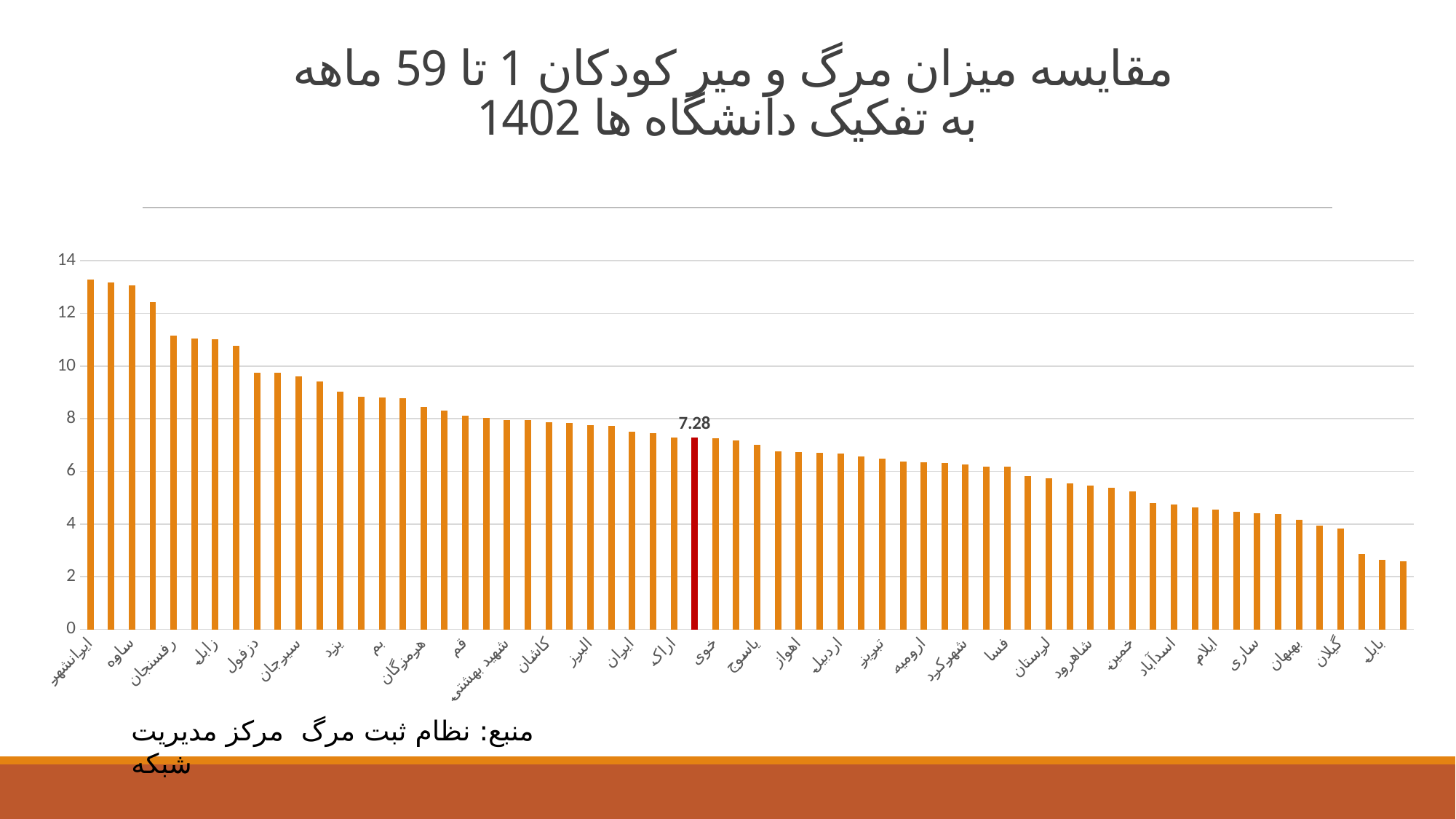
Is the value for خوی greater or less than 8? less Is the value for یزد greater or less than 8? greater Is the value for دزفول greater or less than 10? less Do the values rise or fall from left to right along the x axis? Fall What kind of chart is shown on the slide? Bar chart Which has the larger value, ایرانشهر or بابل? ایرانشهر Which has the larger value, قم or اهواز? قم